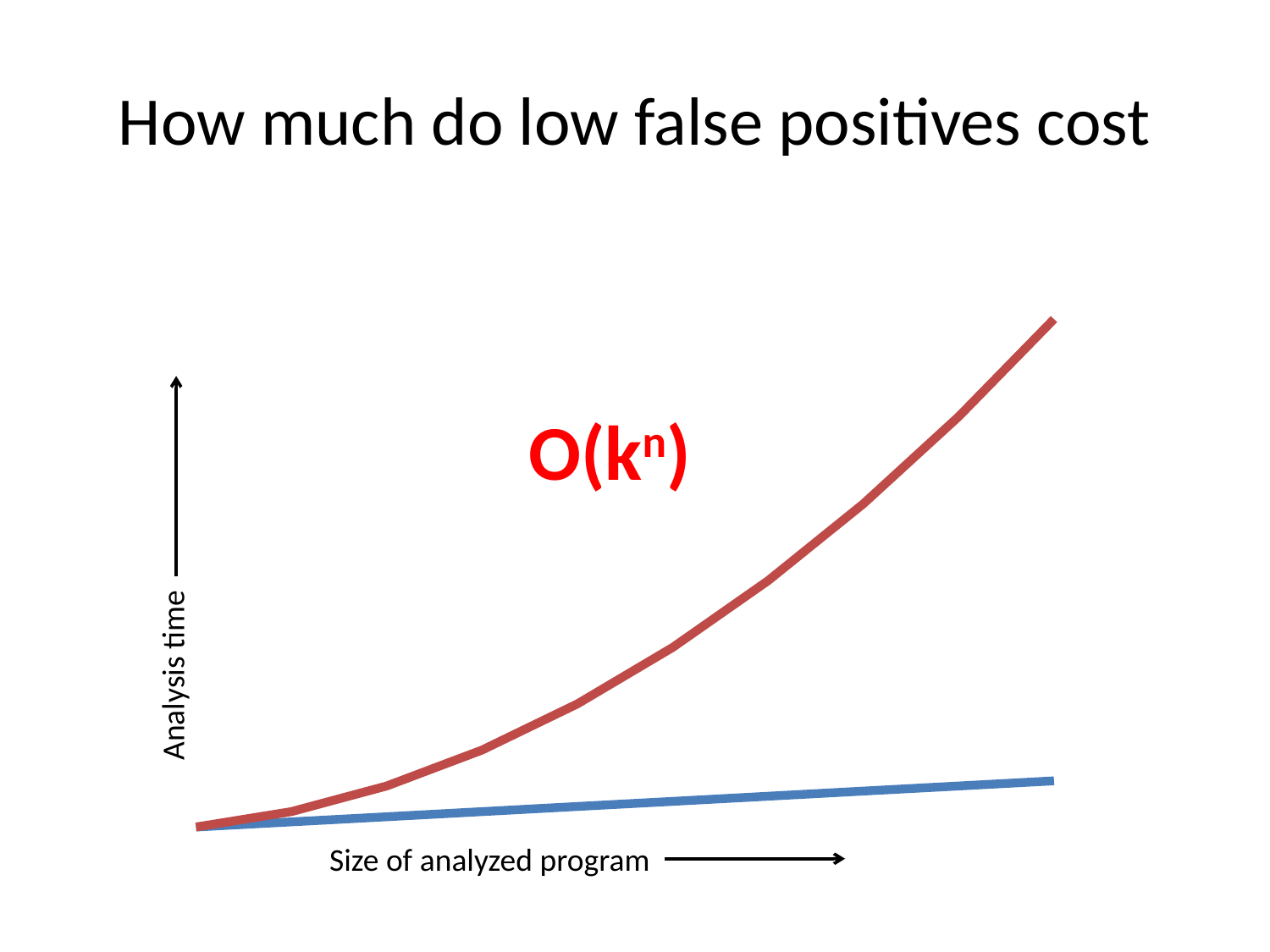
At the right end of the chart, which line is higher, the red line or the blue line? the red line What kind of chart is shown on the slide? line chart Which line grows roughly linearly, the red or the blue? the blue line What is the label on the vertical axis of the chart? Analysis time Does the blue line rise or fall along the x axis? rise How many lines are plotted on the chart? 2 Does the red line rise or fall as the size of the analyzed program increases? rise What complexity annotation is written in red next to the red curve? O(kⁿ) Which line shows the steeper increase in analysis time, the red or the blue? the red line